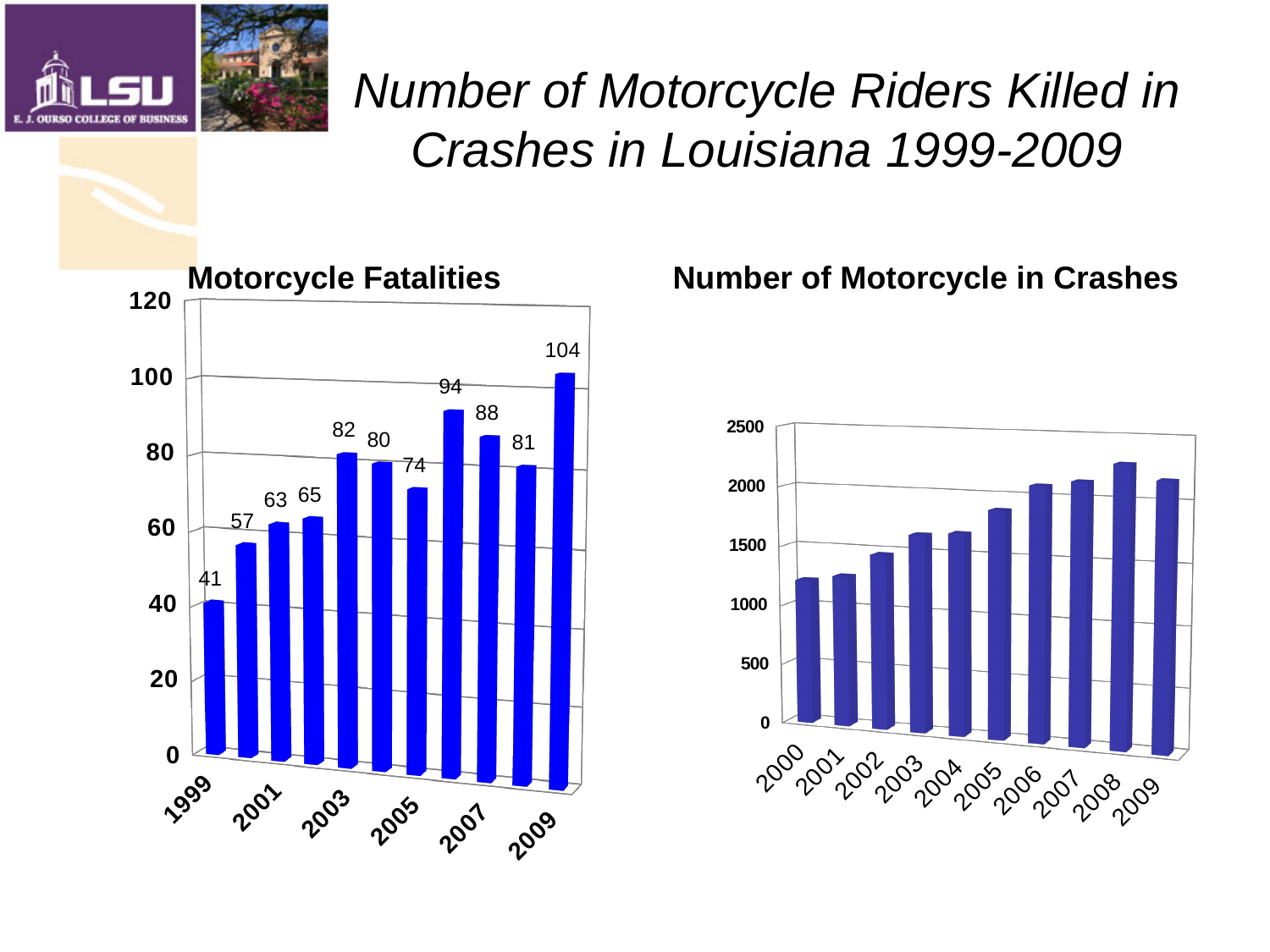
What kind of chart is the Number of Motorcycle in Crashes chart? bar chart In the Motorcycle Fatalities chart, which is larger, the value for 2003 or the value for 2007? 2007 In the Motorcycle Fatalities chart, what is the value for 1999? 41 In the Motorcycle Fatalities chart, what is the value for 2009? 104 In the Number of Motorcycle in Crashes chart, which year has the highest value? 2008 In the Motorcycle Fatalities chart, which year has the lowest value? 1999 In the Motorcycle Fatalities chart, which year has the highest value? 2009 In the Number of Motorcycle in Crashes chart, is the value for 2000 greater or less than 1500? less In the Number of Motorcycle in Crashes chart, is the value for 2008 greater or less than 2000? greater How many bars are in the Motorcycle Fatalities chart? 11 In the Motorcycle Fatalities chart, what is the value for 2005? 74 In the Motorcycle Fatalities chart, what is the difference between the values for 2009 and 1999? 63